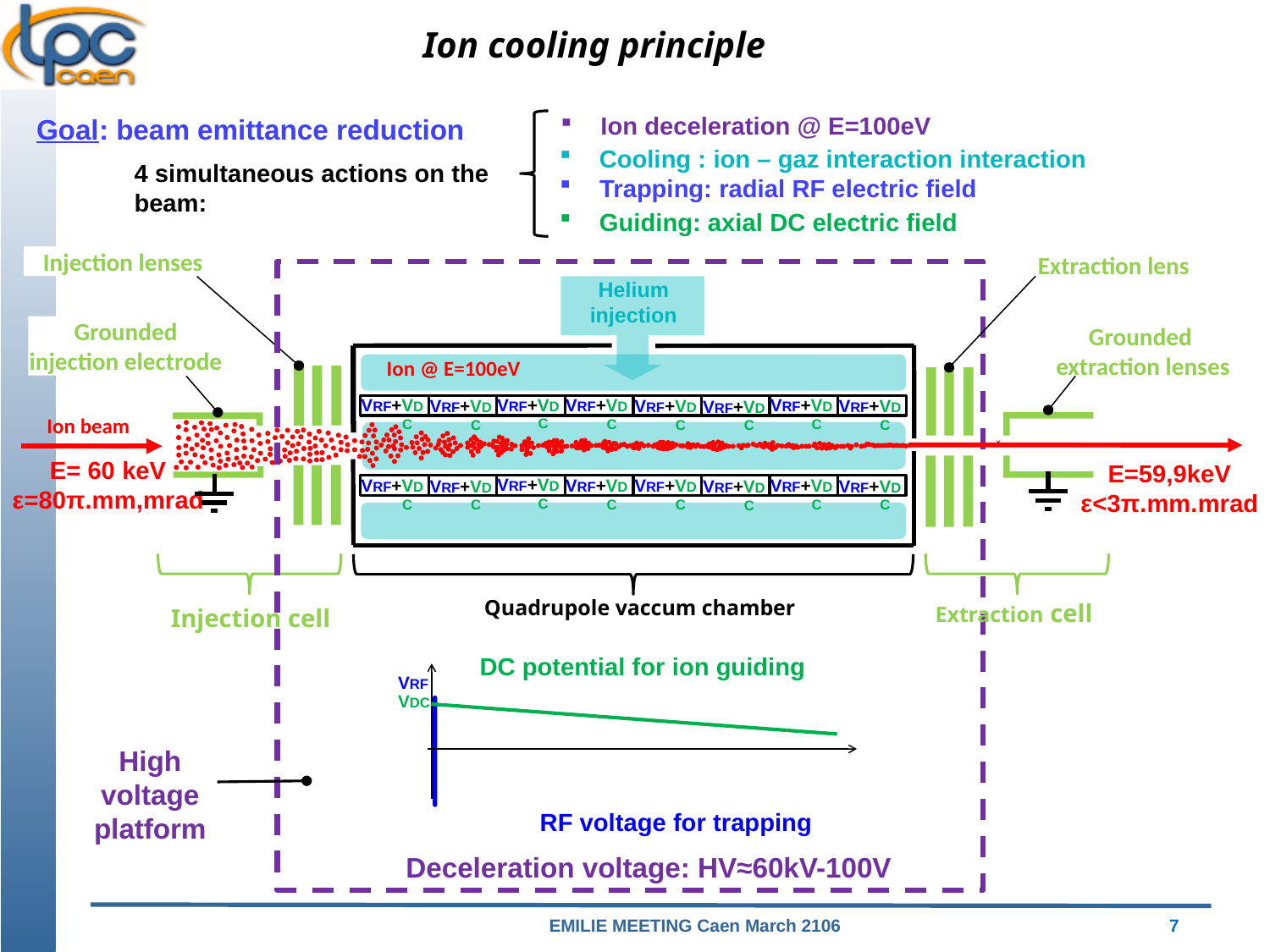
In the small plot at the bottom of the slide, does the green DC potential line rise or fall along the x axis? fall In the small plot at the bottom of the slide, what does the blue vertical trace represent? RF voltage for trapping In the small plot at the bottom of the slide, what does the green line represent? DC potential for ion guiding